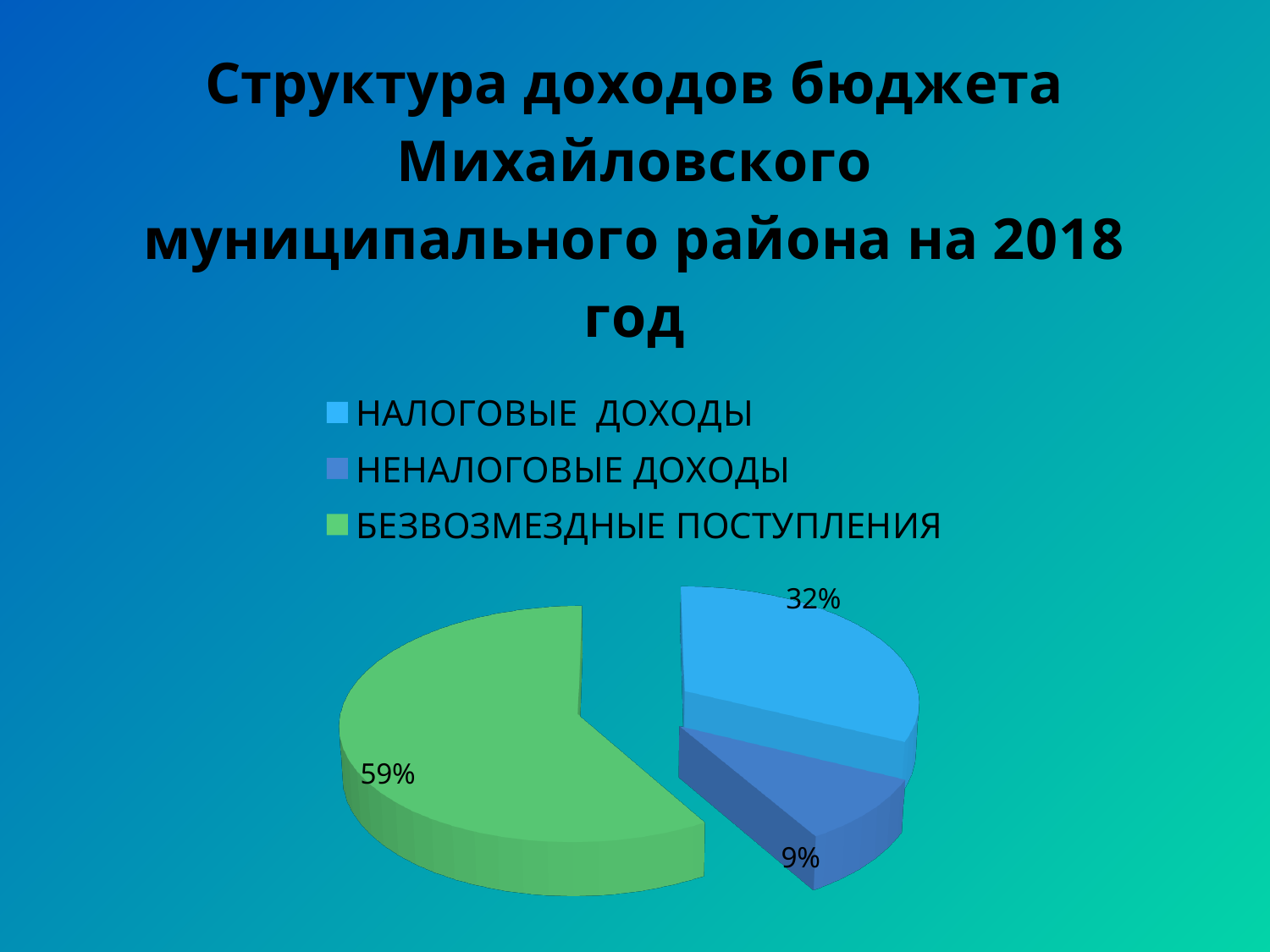
What kind of chart is shown on the slide? pie chart How many slices does the pie chart have? 3 What share of the pie does НЕНАЛОГОВЫЕ ДОХОДЫ have? 9% What is the difference in percentage points between НАЛОГОВЫЕ ДОХОДЫ and НЕНАЛОГОВЫЕ ДОХОДЫ? 23 percentage points What colour is the slice for БЕЗВОЗМЕЗДНЫЕ ПОСТУПЛЕНИЯ? green How many entries does the legend list? 3 Which is larger, the share for НАЛОГОВЫЕ ДОХОДЫ or the share for НЕНАЛОГОВЫЕ ДОХОДЫ? НАЛОГОВЫЕ ДОХОДЫ What share of the pie does БЕЗВОЗМЕЗДНЫЕ ПОСТУПЛЕНИЯ have? 59% Which category has the smallest slice of the pie? НЕНАЛОГОВЫЕ ДОХОДЫ What is the difference in percentage points between БЕЗВОЗМЕЗДНЫЕ ПОСТУПЛЕНИЯ and НАЛОГОВЫЕ ДОХОДЫ? 27 percentage points Which category has the largest slice of the pie? БЕЗВОЗМЕЗДНЫЕ ПОСТУПЛЕНИЯ What share of the pie does НАЛОГОВЫЕ ДОХОДЫ have? 32%